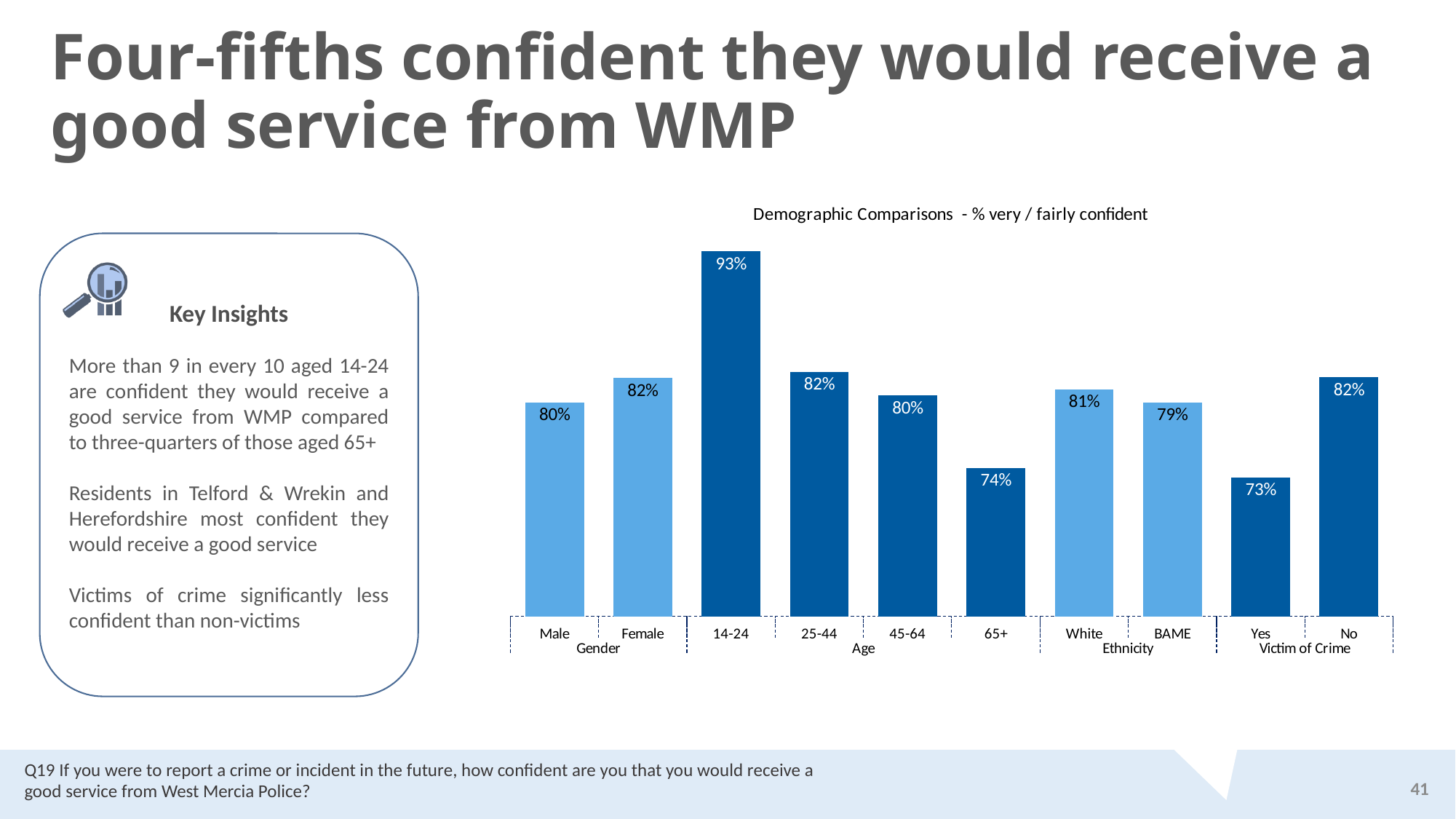
What is the value for BAME respondents? 79% What is the value for Female respondents? 82% What is the difference between non-victims (No) and victims (Yes) of crime? 9 percentage points What is the title of the chart? Demographic Comparisons - % very / fairly confident Which category has the lowest value? Yes (Victim of Crime) How many bars are shown in the chart? 10 What is the value for the 14-24 age group? 93% What is the value for those who answered Yes to being a victim of crime? 73% Which is larger, the value for White or the value for BAME? White Which category has the highest value? 14-24 What kind of chart is shown on the slide? Bar chart What is the difference between the 14-24 and 65+ age groups? 19 percentage points